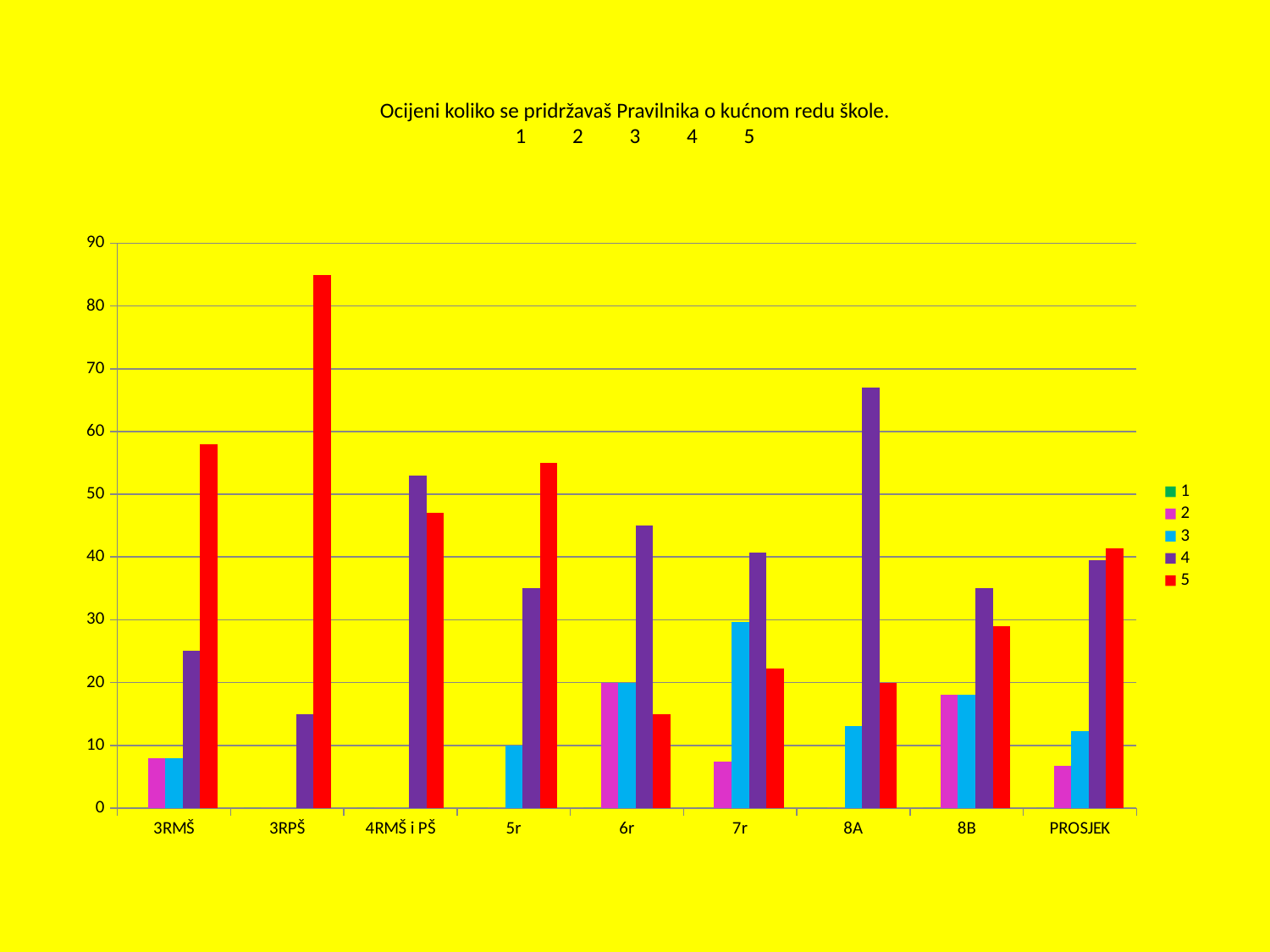
Which category has the highest value for series 5? 3RPŠ Is the value for series 5 in 3RPŠ greater or less than 80? greater Is the value for series 5 in 3RMŠ greater or less than 50? greater Which category has the highest value for series 4? 8A What kind of chart is shown on the slide? bar chart What colour represents series 5 in the legend? red Is the value for series 4 in 3RPŠ greater or less than 20? less How many series does the legend list? 5 In the category 4RMŠ i PŠ, which series has the larger value, series 4 or series 5? series 4 Which category has the lowest value for series 5? 6r How many categories are shown on the x axis? 9